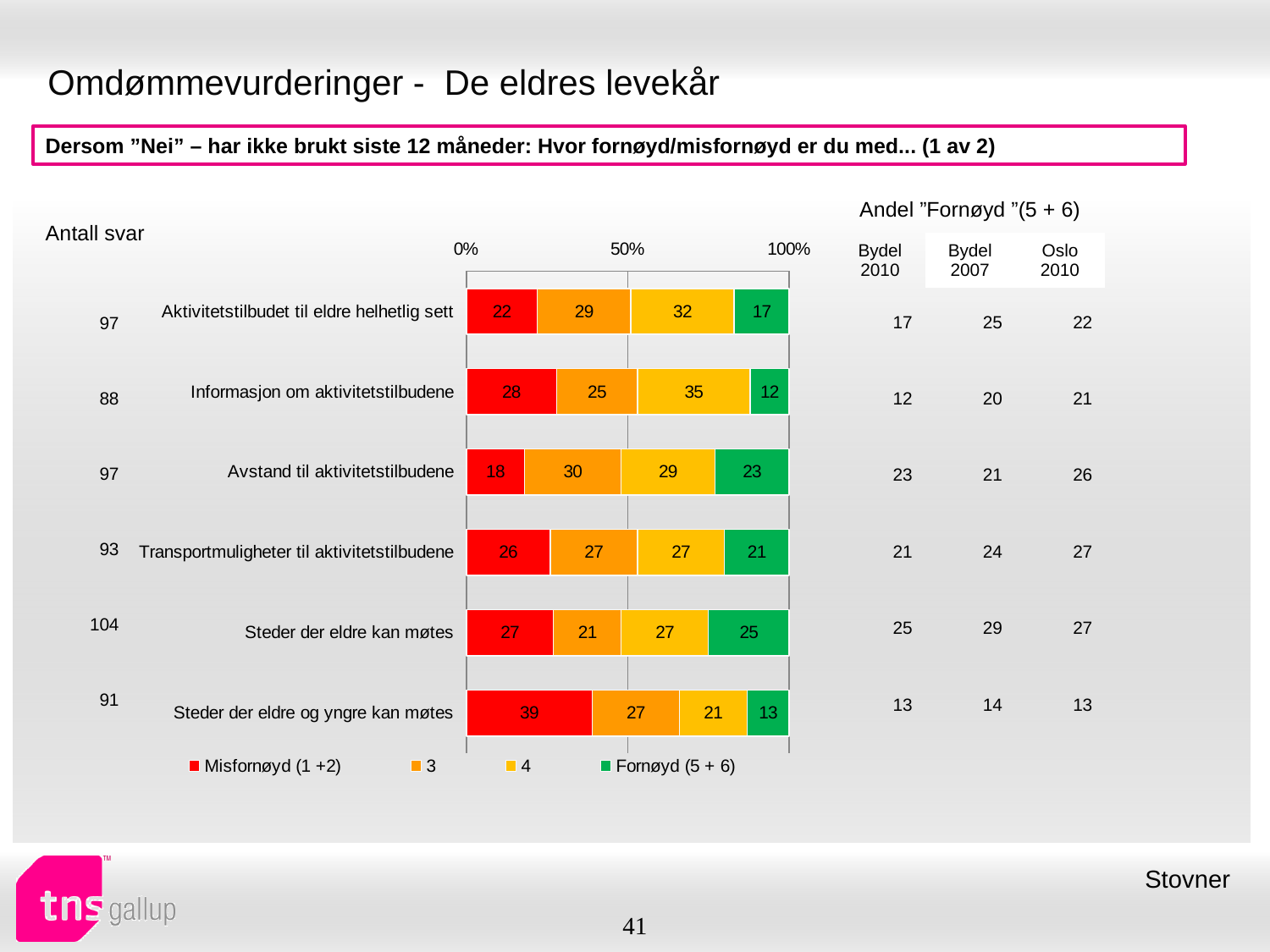
What colour represents the 'Fornøyd (5 + 6)' series in the chart? green What is the difference between the 'Fornøyd (5 + 6)' values for 'Steder der eldre kan møtes' and 'Steder der eldre og yngre kan møtes'? 12 Which category has the highest 'Misfornøyd (1 +2)' value? Steder der eldre og yngre kan møtes What is the value of 'Fornøyd (5 + 6)' for 'Avstand til aktivitetstilbudene'? 23 What is the total of the stacked bar for 'Aktivitetstilbudet til eldre helhetlig sett'? 100 What kind of chart is shown on the slide? stacked bar chart How many series does the chart legend list? 4 What is the value of series '4' for 'Informasjon om aktivitetstilbudene'? 35 Which category has the lowest 'Fornøyd (5 + 6)' value? Informasjon om aktivitetstilbudene How many categories are plotted in the chart? 6 What is the value of 'Misfornøyd (1 +2)' for 'Steder der eldre og yngre kan møtes'? 39 Which is larger: the 'Misfornøyd (1 +2)' value for 'Informasjon om aktivitetstilbudene' or for 'Avstand til aktivitetstilbudene'? Informasjon om aktivitetstilbudene